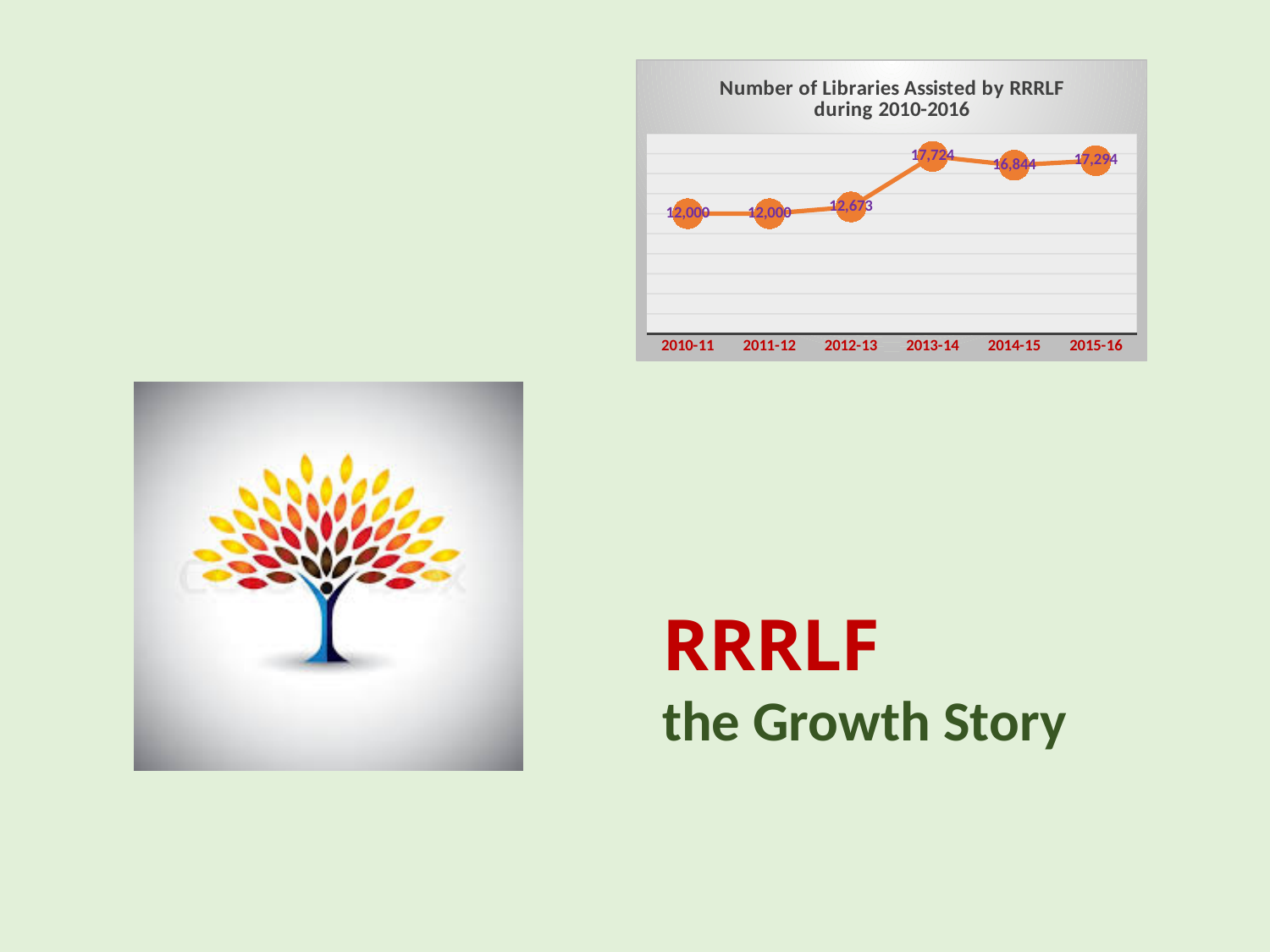
What is the number of libraries assisted by RRRLF in 2013-14? 17,724 Which year has the highest number of libraries assisted by RRRLF? 2013-14 How many years are plotted on the chart? 6 What is the number of libraries assisted by RRRLF in 2012-13? 12,673 What is the title of the chart? Number of Libraries Assisted by RRRLF during 2010-2016 What is the difference between the number of libraries assisted in 2013-14 and in 2014-15? 880 Which year has a larger number of libraries assisted, 2014-15 or 2015-16? 2015-16 What is the number of libraries assisted by RRRLF in 2015-16? 17,294 What is the lowest number of libraries assisted shown on the chart? 12,000 What is the difference between the number of libraries assisted in 2012-13 and in 2011-12? 673 What kind of chart is shown on the slide? Line chart What is the number of libraries assisted by RRRLF in 2014-15? 16,844